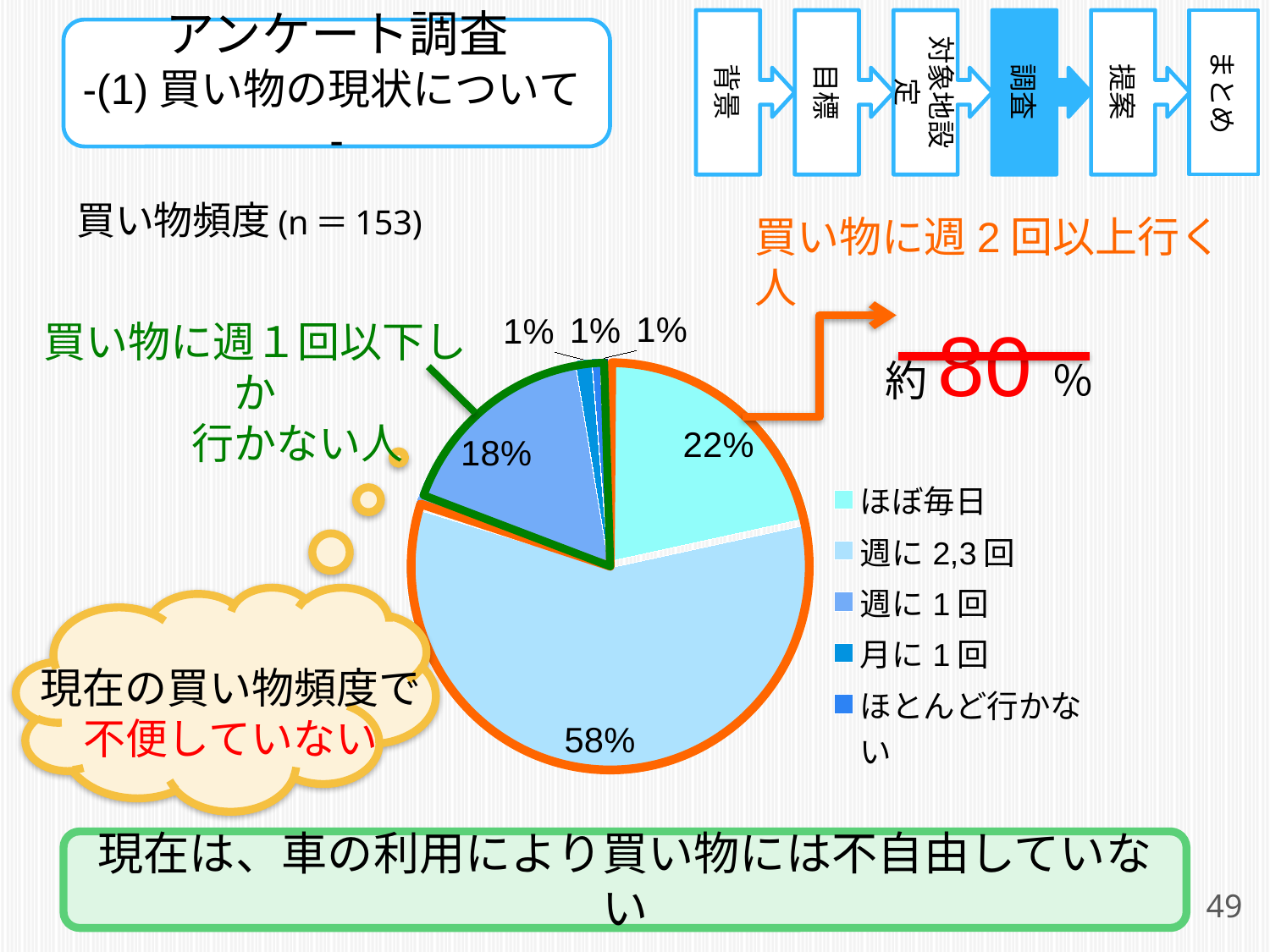
Which slice is larger, ほぼ毎日 or 週に1回? ほぼ毎日 Which category has the largest slice of the pie chart? 週に2,3回 What type of chart is shown on the slide? Pie chart What is the sample size (n) given in the chart heading? 153 What is the difference in percentage points between the 週に2,3回 slice and the ほぼ毎日 slice? 36 percentage points How many entries does the chart legend list? 5 What percentage does the ほぼ毎日 slice show? 22% How many percentage points larger is the ほぼ毎日 slice than the 週に1回 slice? 4 percentage points What is the value labelled on the 週に1回 slice? 18% What percentage of the pie chart is the 週に2,3回 slice? 58% Is the value for 週に2,3回 greater or less than 50%? greater What is the combined share of the ほぼ毎日 and 週に2,3回 slices? 80%